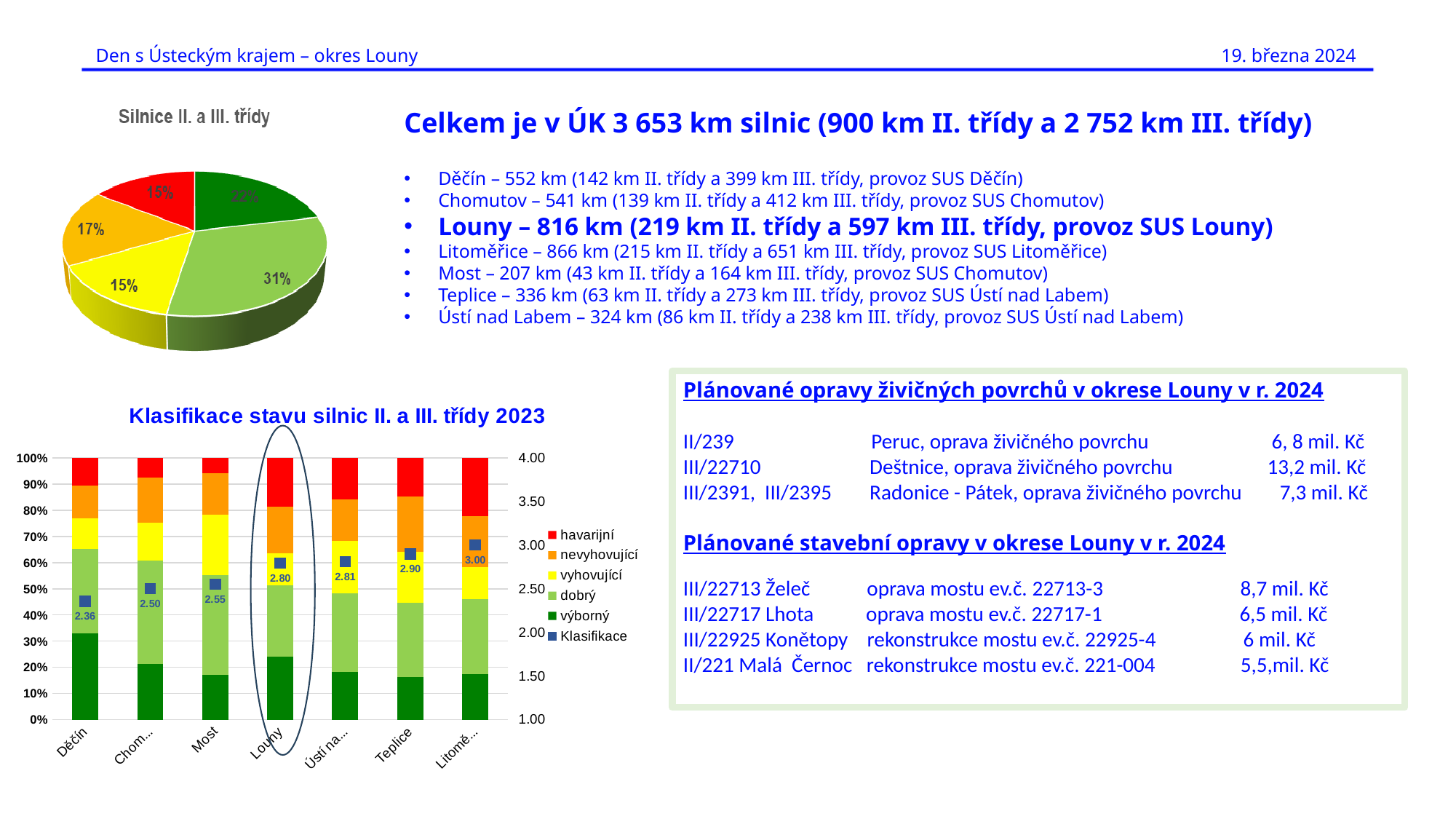
In the chart 'Klasifikace stavu silnic II. a III. třídy 2023', which category has the lowest Klasifikace value? Děčín In the chart 'Klasifikace stavu silnic II. a III. třídy 2023', which has the higher Klasifikace value, Teplice or Most? Teplice In the pie chart 'Silnice II. a III. třídy', what is the share of the largest slice? 31% In the chart 'Klasifikace stavu silnic II. a III. třídy 2023', what is the difference between the Klasifikace values for Louny and Děčín? 0.44 How many categories are shown on the x axis of the chart 'Klasifikace stavu silnic II. a III. třídy 2023'? 7 How many slices does the pie chart 'Silnice II. a III. třídy' have? 5 In the chart 'Klasifikace stavu silnic II. a III. třídy 2023', what is the Klasifikace value for Teplice? 2.90 In the chart 'Klasifikace stavu silnic II. a III. třídy 2023', what is the Klasifikace value for Louny? 2.80 How many series does the legend of the chart 'Klasifikace stavu silnic II. a III. třídy 2023' list? 6 In the chart 'Klasifikace stavu silnic II. a III. třídy 2023', what is the Klasifikace value for Děčín? 2.36 What kind of chart is the chart titled 'Silnice II. a III. třídy'? pie chart In the chart 'Klasifikace stavu silnic II. a III. třídy 2023', do the Klasifikace values rise or fall from left to right along the x axis? rise